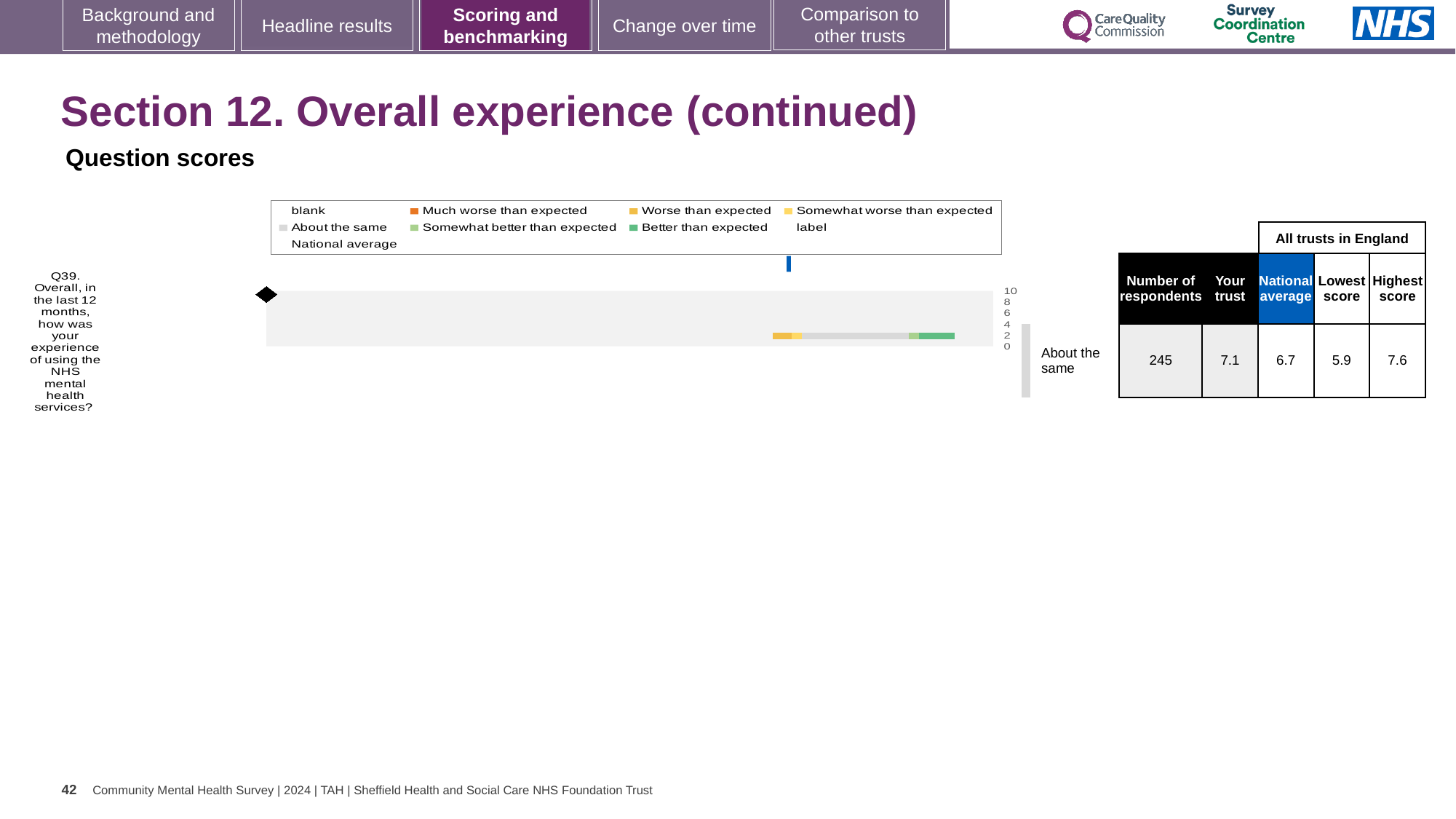
What is the highest score among all trusts in England for Q39? 7.6 What benchmark category is the trust's Q39 score placed in? About the same Which is larger for Q39, the 'Your trust' score or the national average? Your trust What is the 'Your trust' score for Q39? 7.1 What type of chart is used to show the Q39 question score? bar chart How many survey questions are plotted on the chart? 1 What is the lowest score among all trusts in England for Q39? 5.9 What is the difference between the 'Your trust' score and the national average for Q39? 0.4 What is the difference between the highest and lowest scores for Q39 across all trusts in England? 1.7 How many respondents answered Q39? 245 What is the heading above the chart? Question scores What is the national average score for Q39? 6.7